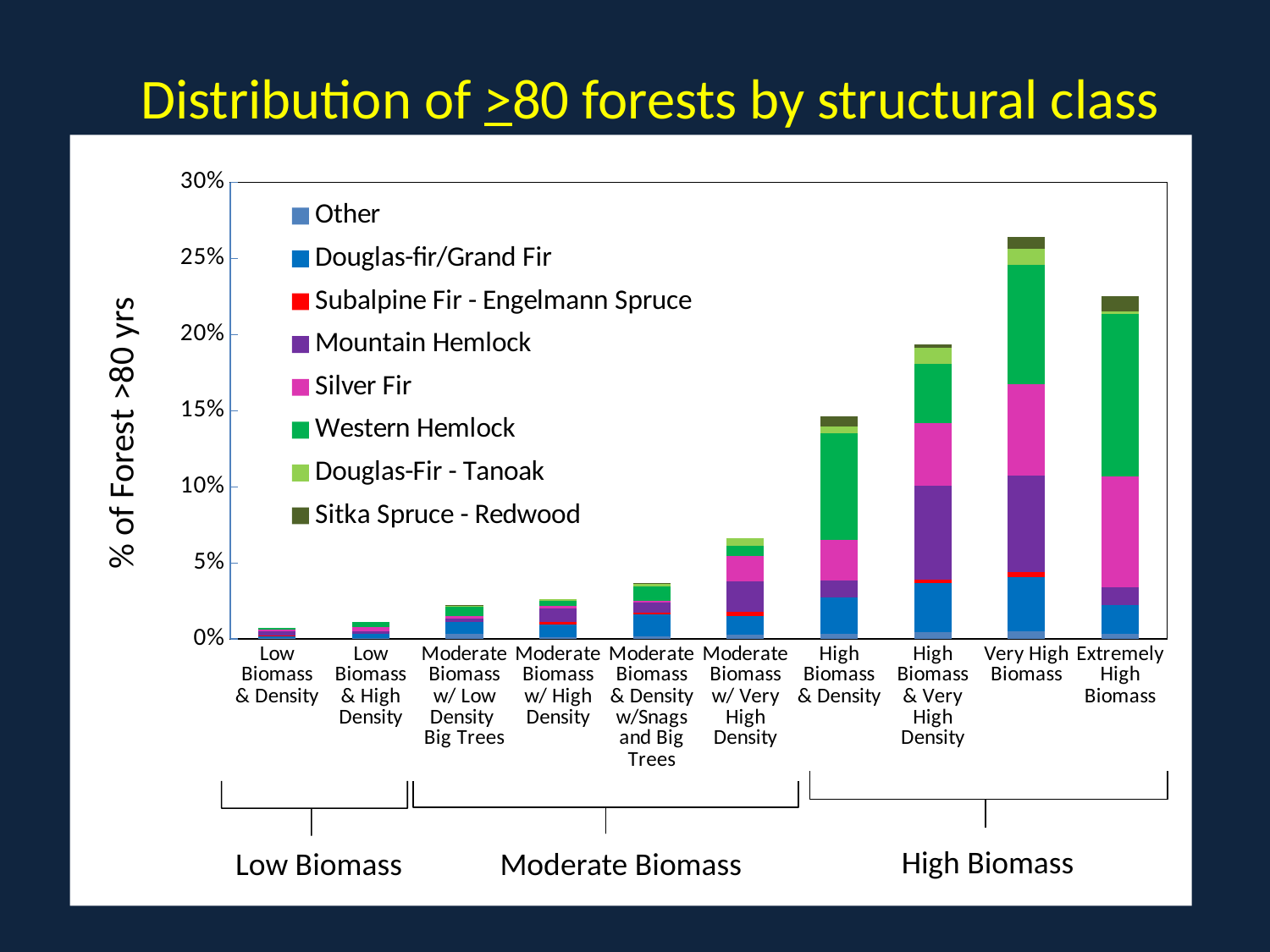
How many structural classes (bars) are shown along the x axis? 10 Do the total bar heights generally rise or fall moving from left to right along the x axis? rise Is the total value for Moderate Biomass w/ Very High Density greater or less than 5%? greater Which has a larger total: Extremely High Biomass or High Biomass & Very High Density? Extremely High Biomass What is the label on the y axis of the chart? % of Forest >80 yrs Is the total value for Very High Biomass greater or less than 25%? greater What kind of chart is shown on the slide? Stacked bar chart How many series does the legend list? 8 Which structural class has the lowest total percentage of forest >80 yrs? Low Biomass & Density Is the total value for Extremely High Biomass greater or less than 20%? greater Which structural class has the highest total percentage of forest >80 yrs? Very High Biomass